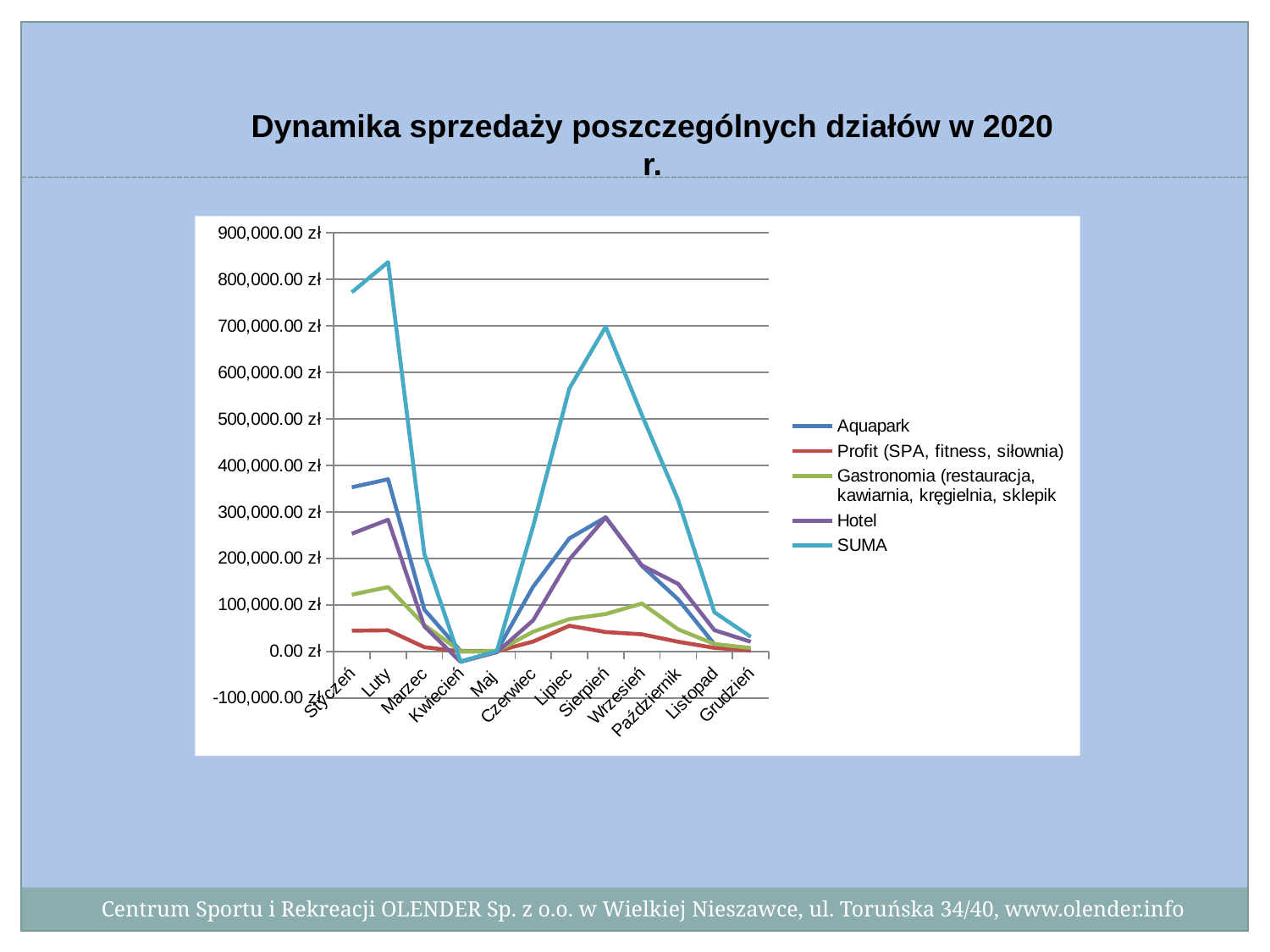
In which month does the SUMA series reach its lowest value? Kwiecień Is the SUMA value for Sierpień greater or less than 600,000.00 zł? greater What kind of chart is shown on the slide? line chart Is the SUMA value for Luty greater or less than 800,000.00 zł? greater How many series does the legend list? 5 Is the Aquapark value for Styczeń greater or less than 300,000.00 zł? greater Does the SUMA series rise or fall from Sierpień to Grudzień? fall In which month does the SUMA series reach its highest value? Luty What is the title of the chart? Dynamika sprzedaży poszczególnych działów w 2020 r. How many months are shown along the x axis? 12 Which is larger in Styczeń, the Aquapark value or the Hotel value? Aquapark